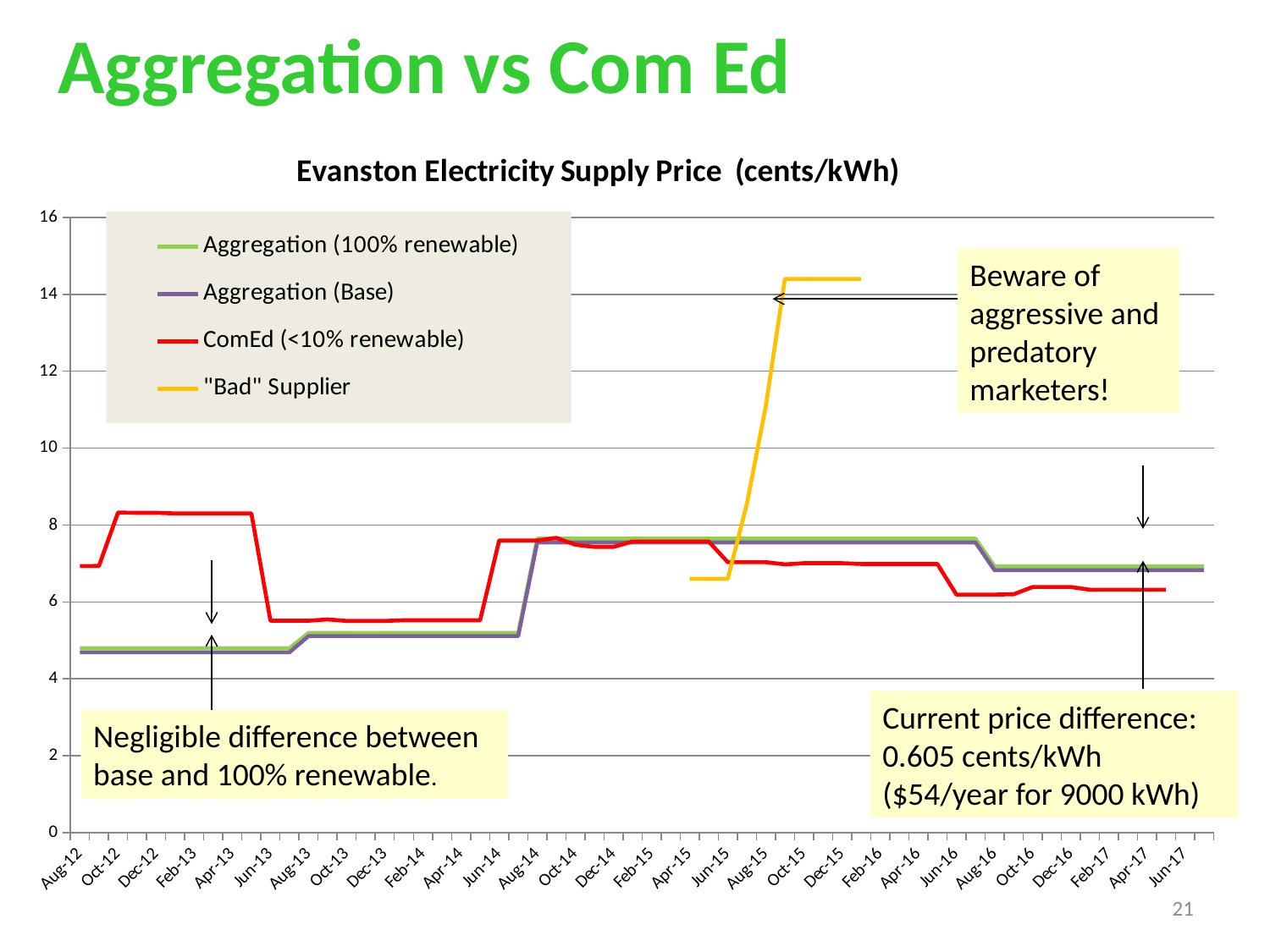
In Dec-12, which is higher: ComEd (<10% renewable) or Aggregation (Base)? ComEd (<10% renewable) Which series reaches the highest value on the chart? "Bad" Supplier Does the "Bad" Supplier series rise or fall between Jun-15 and Oct-15? Rise What kind of chart is shown on the slide? Line chart Is the value for ComEd (<10% renewable) in Dec-12 greater or less than 8? greater What is the title of the chart? Evanston Electricity Supply Price (cents/kWh) Is the peak value of the "Bad" Supplier series greater or less than 14? greater Is the value for Aggregation (Base) in Aug-12 greater or less than 6? less How many series does the legend list? 4 Which colour is used for the ComEd (<10% renewable) series? Red